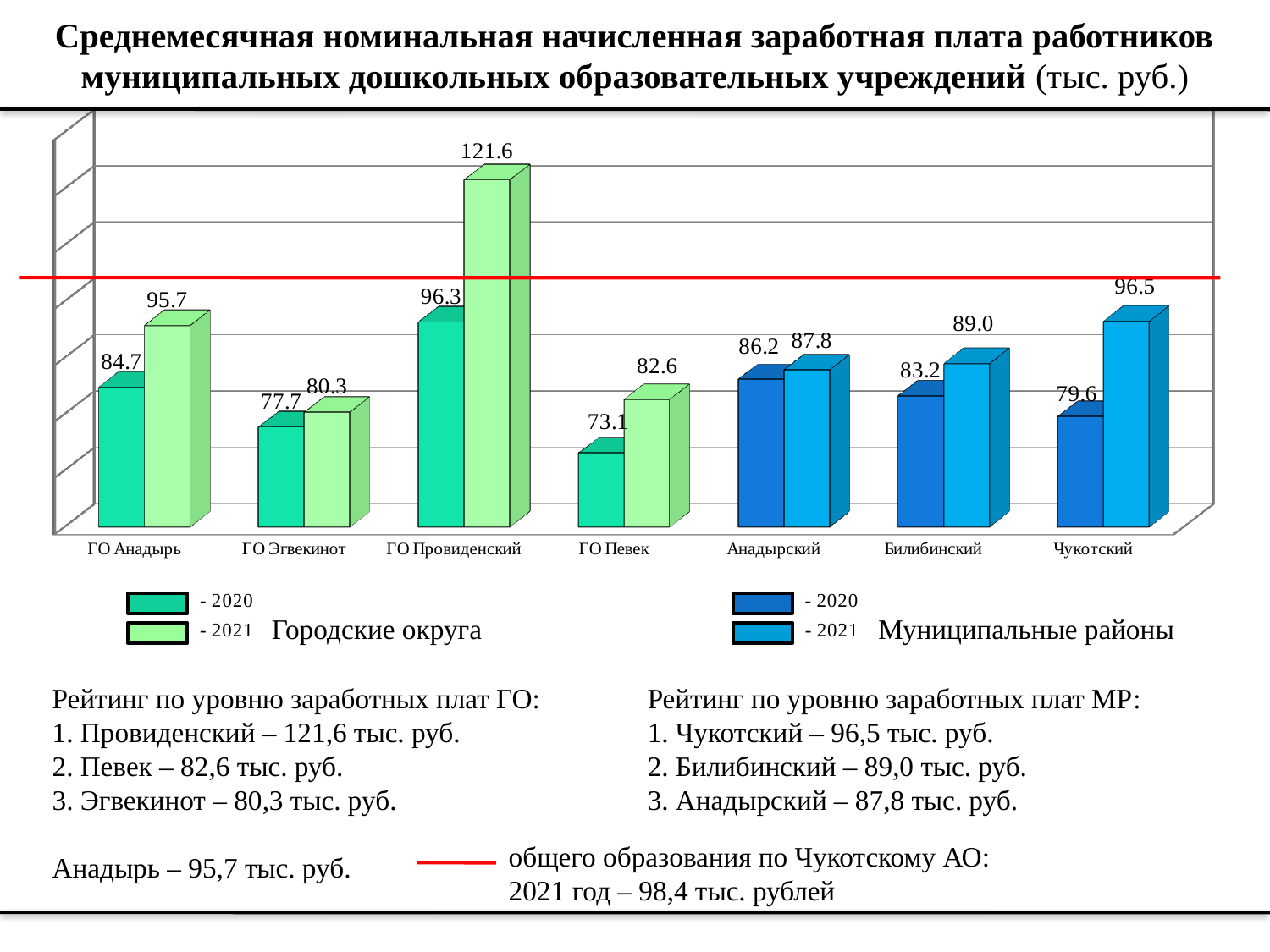
What is the 2020 value for Билибинский? 83.2 What is the difference between the 2021 and 2020 values for ГО Провиденский? 25.3 What is the 2021 value for ГО Провиденский? 121.6 How many categories are shown on the x axis? 7 Which is larger: the 2021 value for ГО Анадырь or the 2021 value for Чукотский? Чукотский Which category has the lowest 2020 value? ГО Певек Which category has the highest 2021 value? ГО Провиденский What is the 2021 value for Чукотский? 96.5 What is the difference between the 2021 and 2020 values for Чукотский? 16.9 What kind of chart is shown on the slide? bar chart What is the 2020 value for ГО Певек? 73.1 Which category has the lowest 2021 value? ГО Эгвекинот